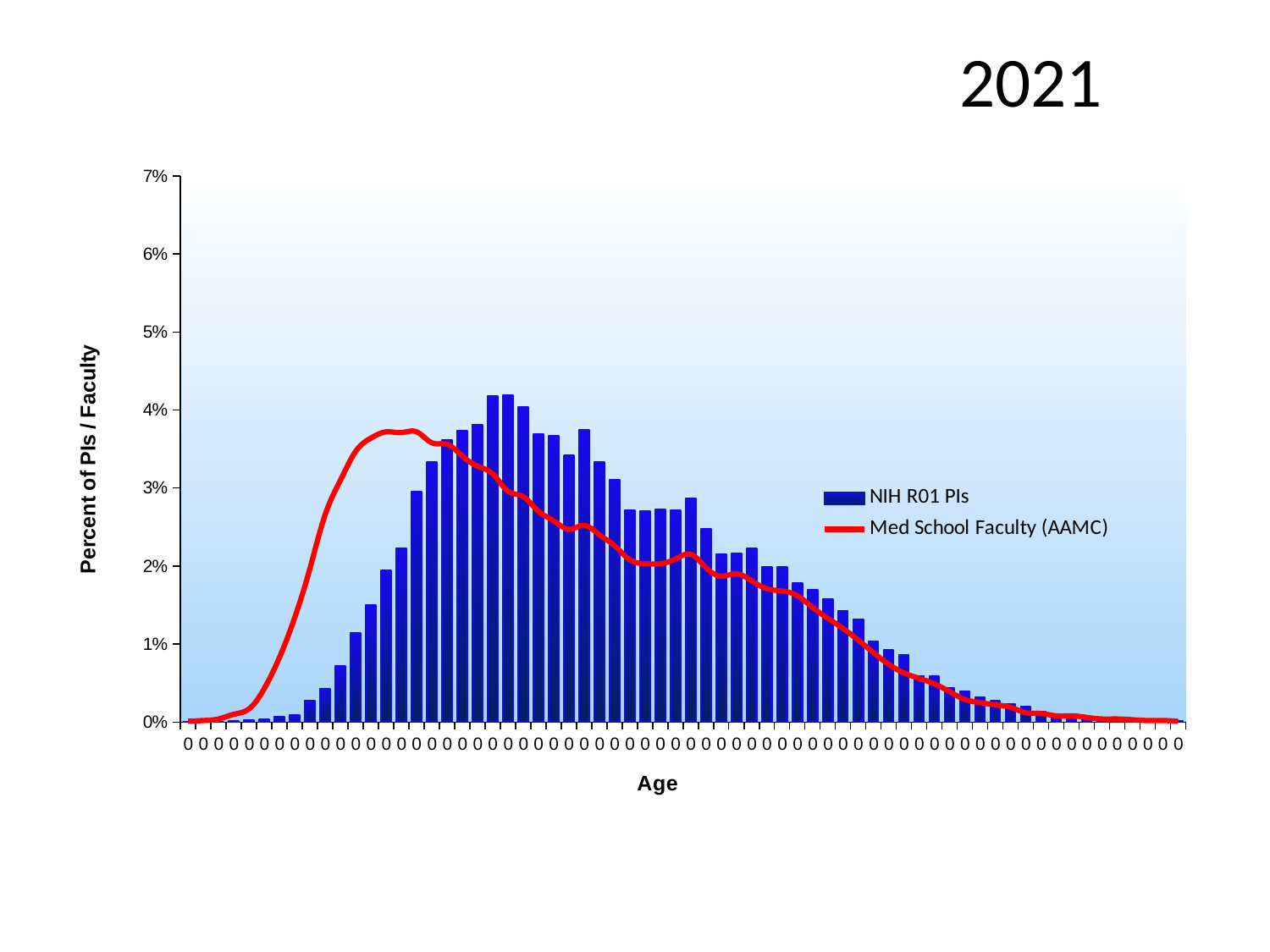
What is the label of the x axis? Age What is the label of the y axis? Percent of PIs / Faculty Which series is drawn as a red line? Med School Faculty (AAMC) What is the highest value shown on the y axis? 7% Is the peak of the Med School Faculty (AAMC) line greater or less than 4%? less How many series does the legend list? 2 Which series reaches a higher peak value, NIH R01 PIs or Med School Faculty (AAMC)? NIH R01 PIs After reaching its peak, does the Med School Faculty (AAMC) line rise or fall as age increases along the x axis? fall Is the tallest NIH R01 PIs bar greater or less than 4%? greater What kind of chart is shown on the slide? A bar chart with a line overlay Which series is drawn as blue bars? NIH R01 PIs What year is shown as the title of the slide? 2021